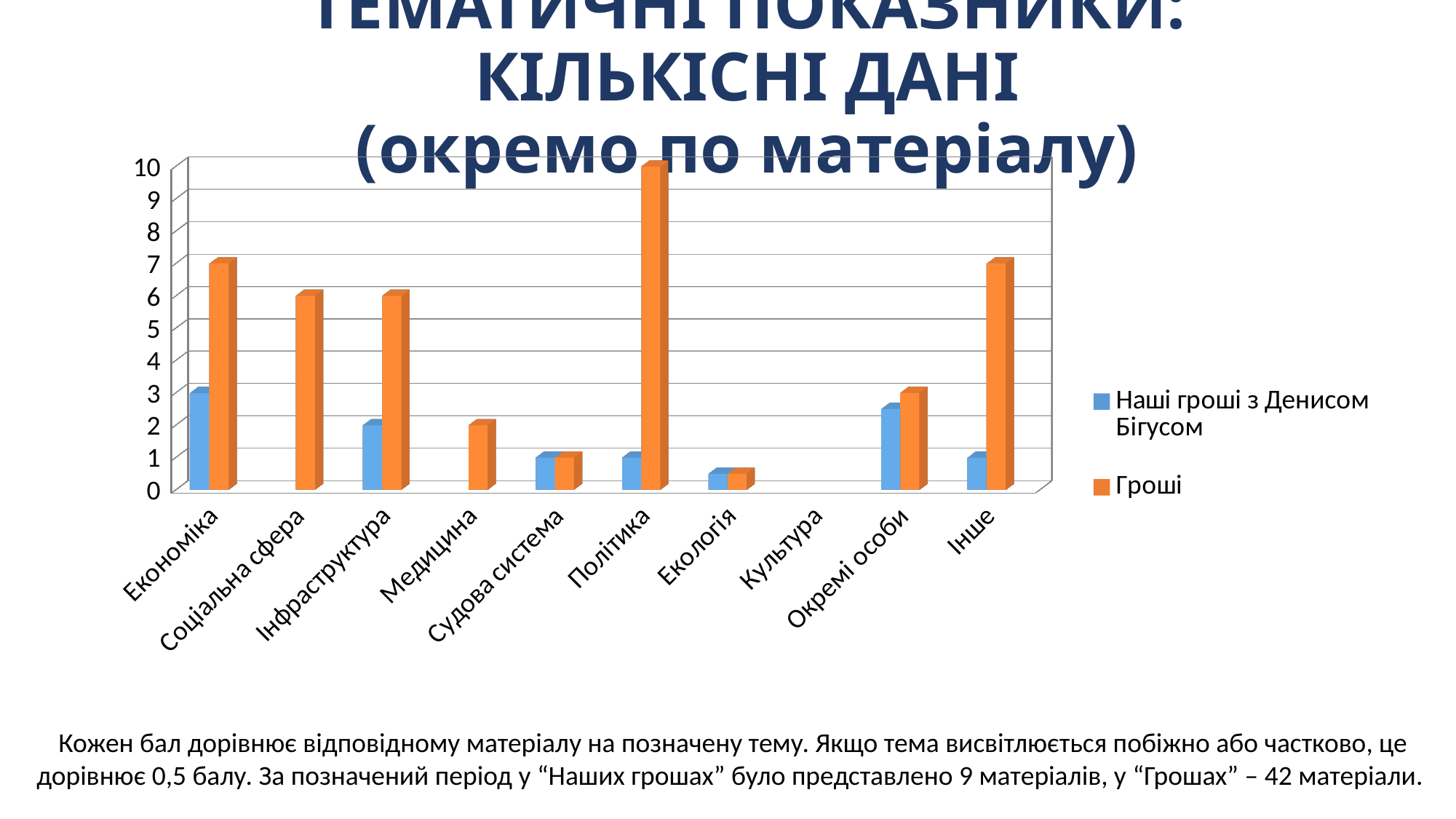
Is the value for "Гроші" in "Медицина" greater or less than 4? less What kind of chart is shown on the slide? bar chart How many series does the legend list? 2 Which colour represents the series "Гроші" in the chart? orange How many categories are shown on the x axis? 10 Is the value for "Наші гроші з Денисом Бігусом" in "Інфраструктура" greater or less than 4? less Is the value for "Гроші" in "Економіка" greater or less than 5? greater In the category "Економіка", which series has the larger value: "Наші гроші з Денисом Бігусом" or "Гроші"? Гроші What is the value for "Гроші" in the category "Політика"? 10 Which category has the highest value for the series "Гроші"? Політика For the series "Гроші", which is larger: "Політика" or "Соціальна сфера"? Політика